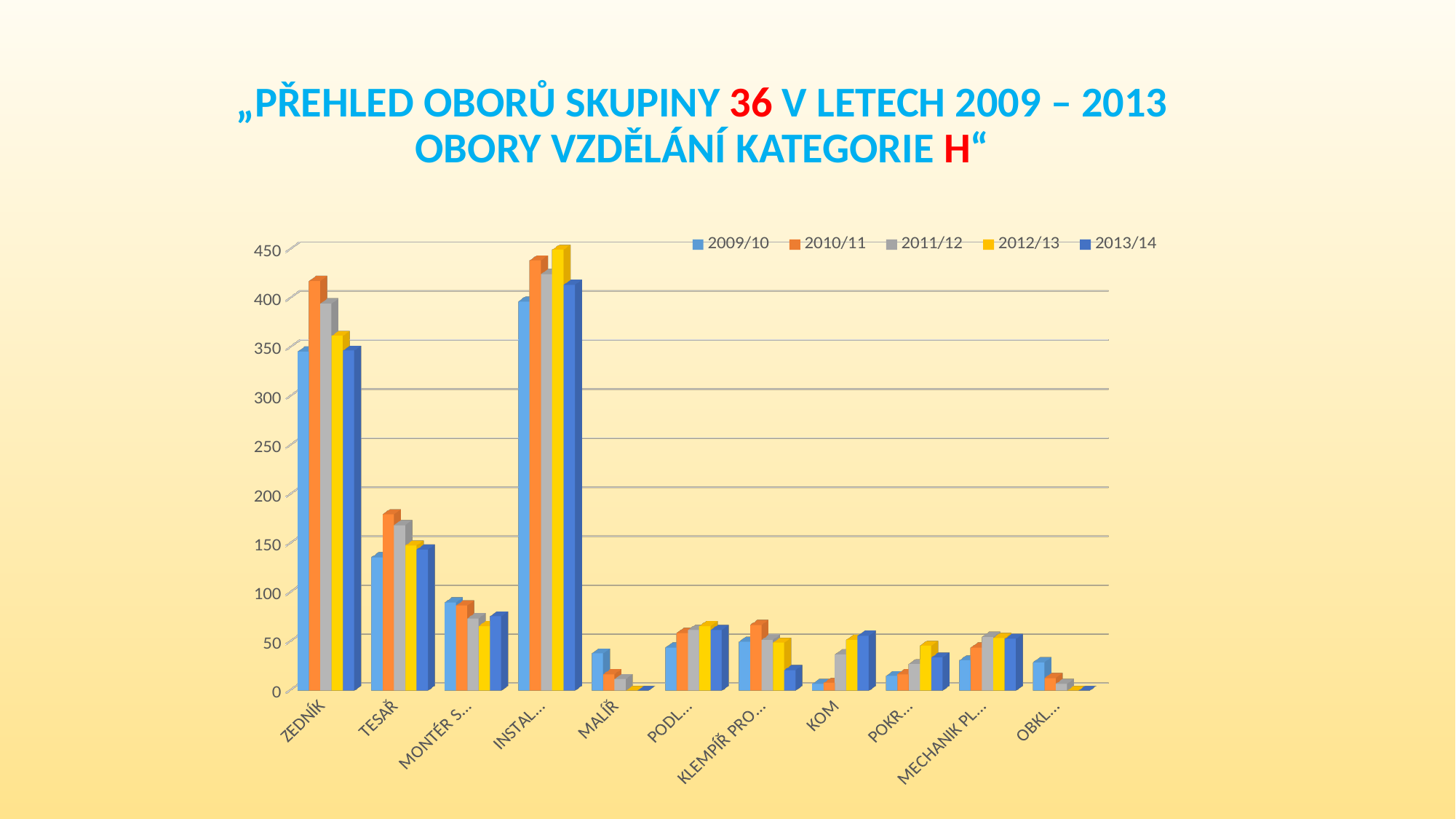
Is the value for ZEDNÍK in 2009/10 greater or less than 300? greater What kind of chart is shown on the slide? bar chart Is the value for TESAŘ in 2010/11 greater or less than 150? greater For ZEDNÍK, which is larger: the 2010/11 value or the 2013/14 value? 2010/11 Is the value for MALÍŘ in 2009/10 greater or less than 50? less How many categories are shown on the x axis? 11 How many series does the legend list? 5 For TESAŘ, which is larger: the 2009/10 value or the 2010/11 value? 2010/11 Do the values for KOM rise or fall from 2009/10 to 2013/14? rise Which series is shown in yellow in the legend? 2012/13 Do the values for MALÍŘ rise or fall from 2009/10 to 2013/14? fall